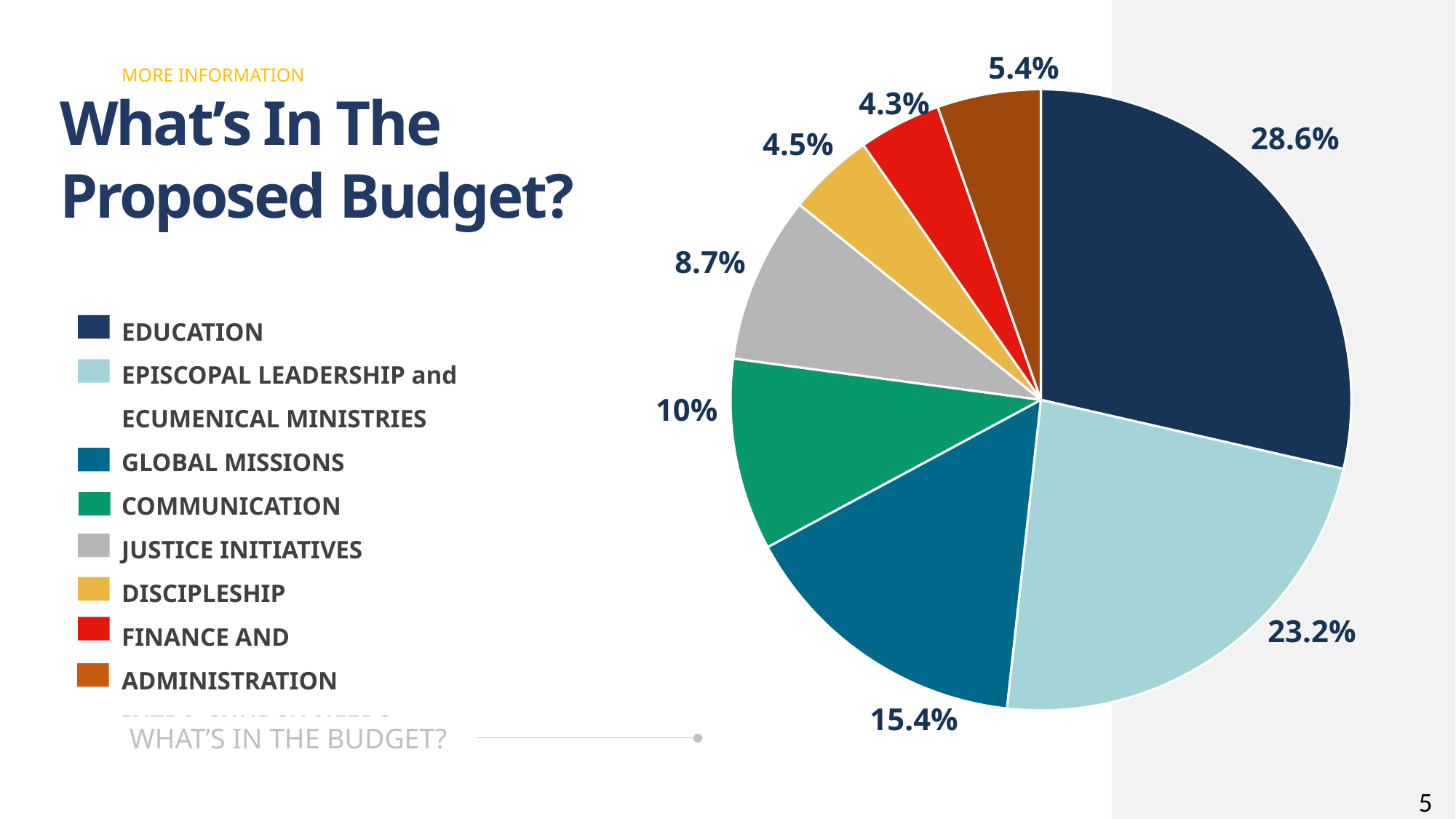
What is the title of the slide containing the pie chart? What's In The Proposed Budget? Which receives a larger share of the proposed budget, Communication or Justice Initiatives? Communication Which category receives the largest share of the proposed budget? Education What type of chart is shown on the slide? Pie chart What share of the proposed budget is for Global Missions? 15.4% What is the difference in percentage points between the Education share and the Global Missions share? 13.2 What share of the proposed budget goes to Education? 28.6% How many slices does the pie chart have? 8 What percentage of the proposed budget goes to Communication? 10% What percentage of the proposed budget is allocated to Episcopal Leadership and Ecumenical Ministries? 23.2% What percentage of the proposed budget is for Discipleship? 4.5% What share of the proposed budget is allocated to Justice Initiatives? 8.7%